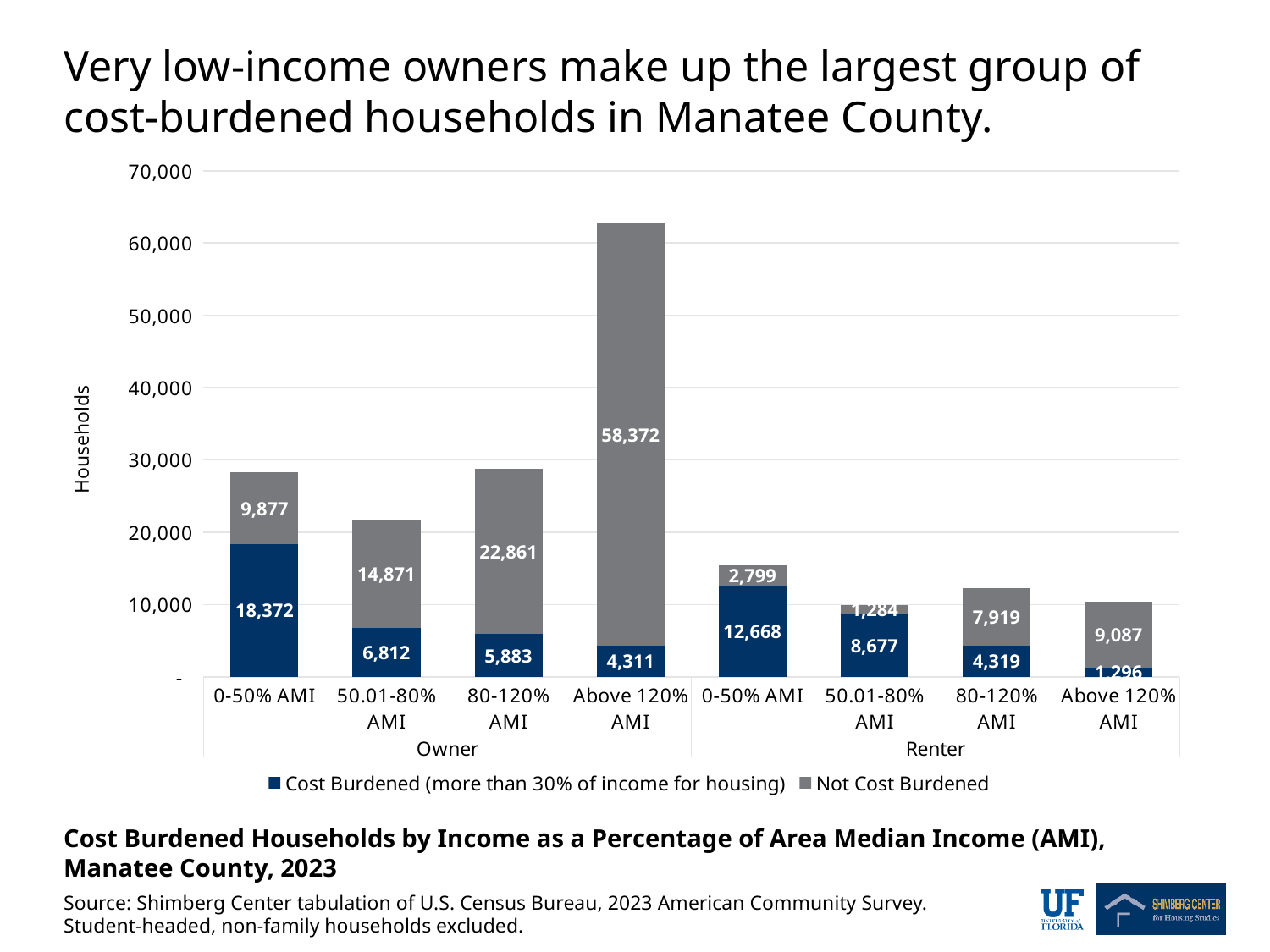
What is the number of cost-burdened renter households in the 50.01-80% AMI group? 8,677 Which group has the highest number of cost-burdened households? Owner 0-50% AMI Which group has the lowest number of cost-burdened households? Renter Above 120% AMI What is the total number of owner households in the 0-50% AMI group (cost burdened plus not cost burdened)? 28,249 What is the number of cost-burdened owner households in the 0-50% AMI group? 18,372 How many bars are plotted in the chart? 8 Which is larger: the number of not cost-burdened renter households at 80-120% AMI or at Above 120% AMI? Above 120% AMI What is the difference between cost-burdened owner households and cost-burdened renter households in the 0-50% AMI group? 5,704 How many series does the legend list? 2 What is the number of not cost-burdened owner households in the Above 120% AMI group? 58,372 Is the total height of the Owner Above 120% AMI bar greater or less than 60,000? greater What kind of chart is shown on the slide? Stacked bar chart